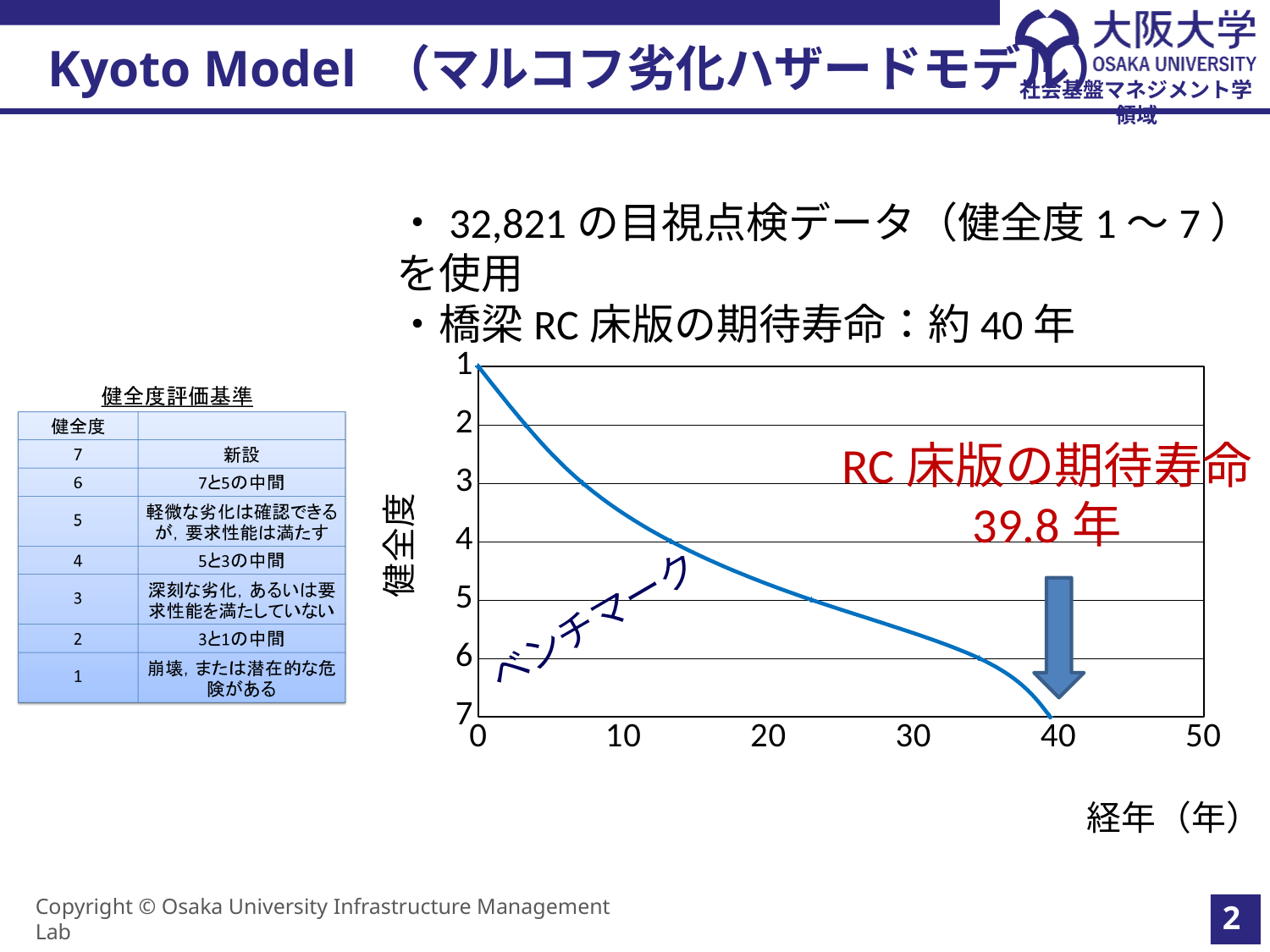
According to the annotation on the chart, what is the expected life (期待寿命) of the RC deck slab? 39.8年 How many data series (lines) are plotted in the chart? 1 As 経年 increases along the x axis, does the 健全度 value of the curve increase or decrease? increase What is the label of the x axis of the chart? 経年（年） How many tick labels are shown on the x axis of the chart? 6 Is the 健全度 value of the curve at 経年 10 years greater or less than 3? greater What is the label of the y axis of the chart? 健全度 Is the 健全度 value of the curve at 経年 20 years greater or less than 5? less What is the 健全度 value of the curve at 経年 0 years? 1 Is the 健全度 value of the curve at 経年 30 years greater or less than 5? greater What kind of chart is shown on the slide? line chart What is the maximum 健全度 value shown on the y axis of the chart? 7